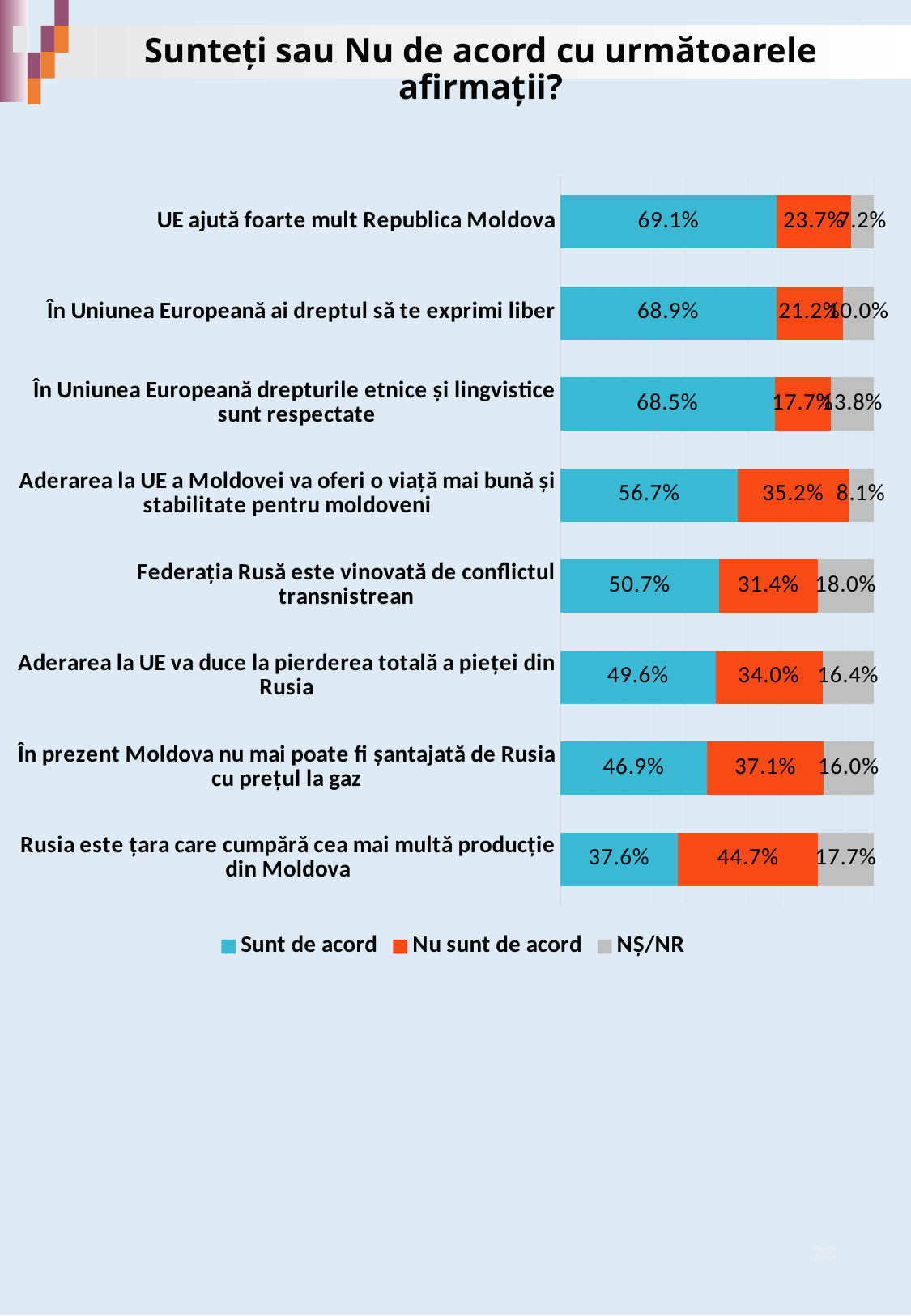
What kind of chart is shown on the slide? Stacked bar chart What is the difference between the 'Sunt de acord' and 'Nu sunt de acord' values for 'Aderarea la UE a Moldovei va oferi o viață mai bună și stabilitate pentru moldoveni'? 21.5% Which colour represents the 'Nu sunt de acord' series? Orange How many series does the legend list? 3 How many statements (categories) are shown in the chart? 8 What is the 'Nu sunt de acord' value for 'Rusia este țara care cumpără cea mai multă producție din Moldova'? 44.7% Which statement has the lowest 'Sunt de acord' value? Rusia este țara care cumpără cea mai multă producție din Moldova What is the 'NȘ/NR' value for 'Aderarea la UE va duce la pierderea totală a pieței din Rusia'? 16.4% What is the 'Sunt de acord' value for 'UE ajută foarte mult Republica Moldova'? 69.1% Which is larger for 'În prezent Moldova nu mai poate fi șantajată de Rusia cu prețul la gaz': 'Sunt de acord' or 'Nu sunt de acord'? Sunt de acord What is the 'NȘ/NR' value for 'Federația Rusă este vinovată de conflictul transnistrean'? 18.0% Which statement has the highest 'Sunt de acord' value? UE ajută foarte mult Republica Moldova